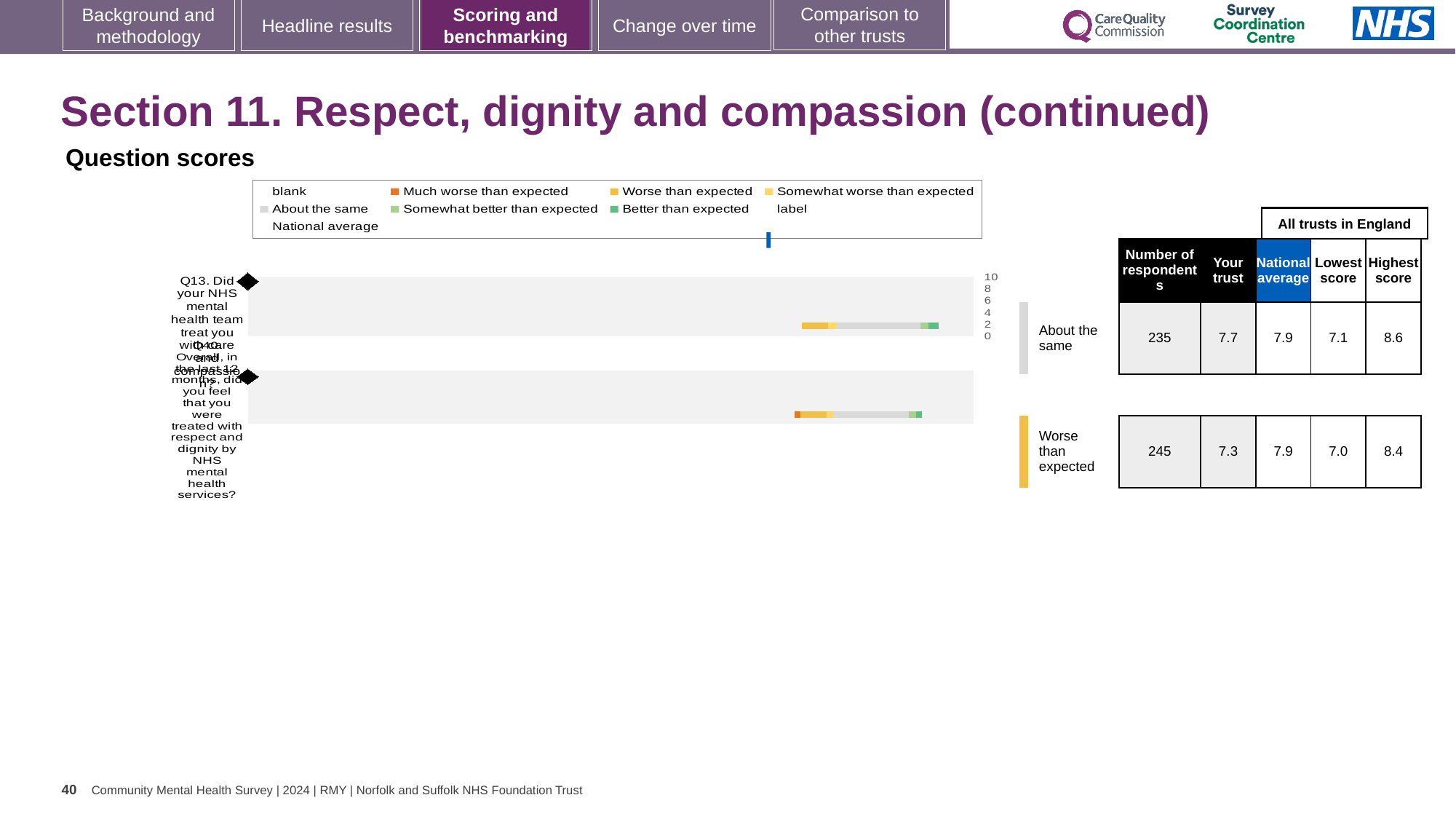
In the table beside the chart, what is the 'Your trust' score for Q14? 7.3 What type of chart is used to show the question scores on this slide? bar chart How many respondents are listed for Q14? 245 Which question has the higher 'Your trust' score, Q13 or Q14? Q13 What benchmark rating is shown for Q14? Worse than expected What is the difference between the national average and the trust's score for Q14? 0.6 How many questions (categories) are plotted in the question scores chart? 2 In the table beside the chart, what is the 'Your trust' score for Q13? 7.7 What is the national average score shown for Q13? 7.9 What is the lowest score across all trusts in England for Q14? 7.0 What is the highest score across all trusts in England for Q13? 8.6 What benchmark rating is shown for Q13? About the same